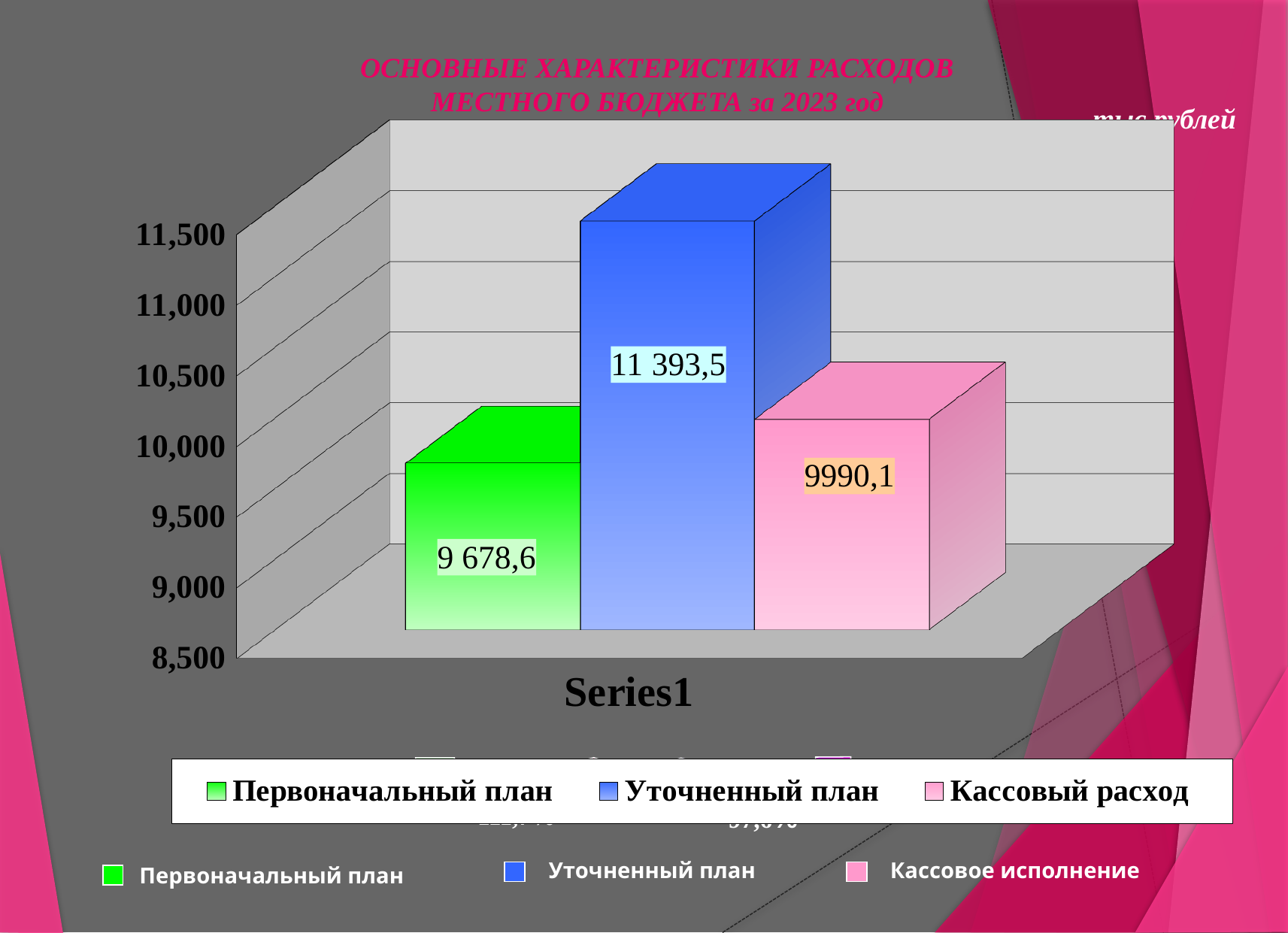
Which is larger, Кассовый расход or Первоначальный план? Кассовый расход What kind of chart is shown on the slide? bar chart How many series does the legend list? 3 What is the value for Первоначальный план? 9 678,6 What is the value for Уточненный план? 11 393,5 What is the value for Кассовый расход? 9990,1 What is the difference between Уточненный план and Первоначальный план? 1 714,9 Which series has the lowest value? Первоначальный план Is the value for Уточненный план greater or less than 11,000? greater Which series has the highest value? Уточненный план What unit is indicated for the chart values? тыс рублей What is the difference between Уточненный план and Кассовый расход? 1 403,4